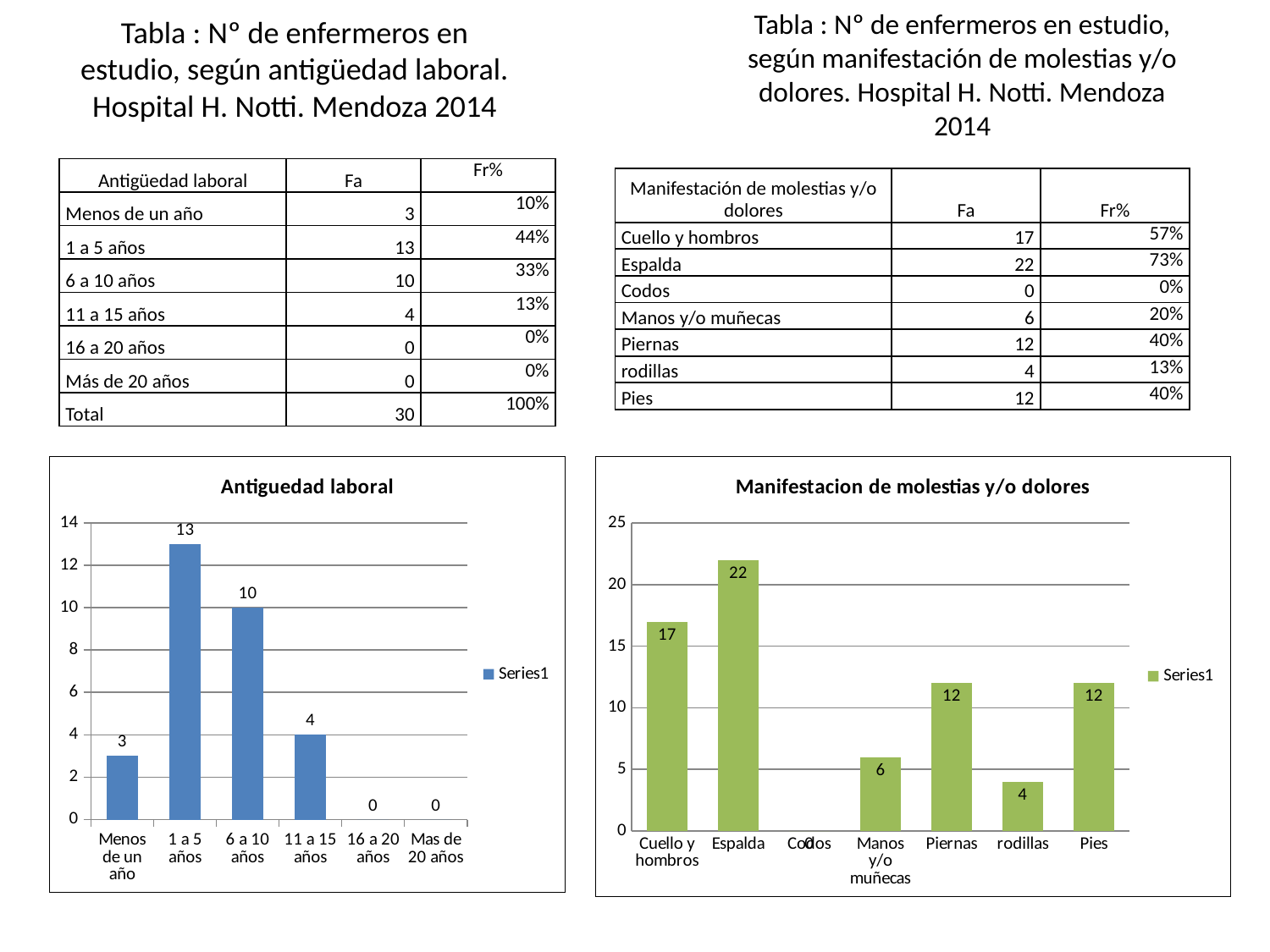
In the 'Manifestacion de molestias y/o dolores' chart, which is larger, 'Cuello y hombros' or 'Piernas'? Cuello y hombros In the 'Antiguedad laboral' chart, how many categories are shown on the x axis? 6 In the 'Antiguedad laboral' chart, which category has the highest value? 1 a 5 años In the 'Manifestacion de molestias y/o dolores' chart, what is the difference between 'Espalda' and 'Cuello y hombros'? 5 In the 'Antiguedad laboral' chart, what is the value for 'Menos de un año'? 3 In the 'Manifestacion de molestias y/o dolores' chart, which category has the highest value? Espalda In the 'Antiguedad laboral' chart, what is the value for '1 a 5 años'? 13 In the 'Manifestacion de molestias y/o dolores' chart, which category has the lowest value? Codos What type of chart is the 'Manifestacion de molestias y/o dolores' chart? Bar chart In the 'Manifestacion de molestias y/o dolores' chart, what is the value for 'Espalda'? 22 In the 'Antiguedad laboral' chart, what is the difference between '6 a 10 años' and '11 a 15 años'? 6 How many series does the legend of the 'Antiguedad laboral' chart list? 1